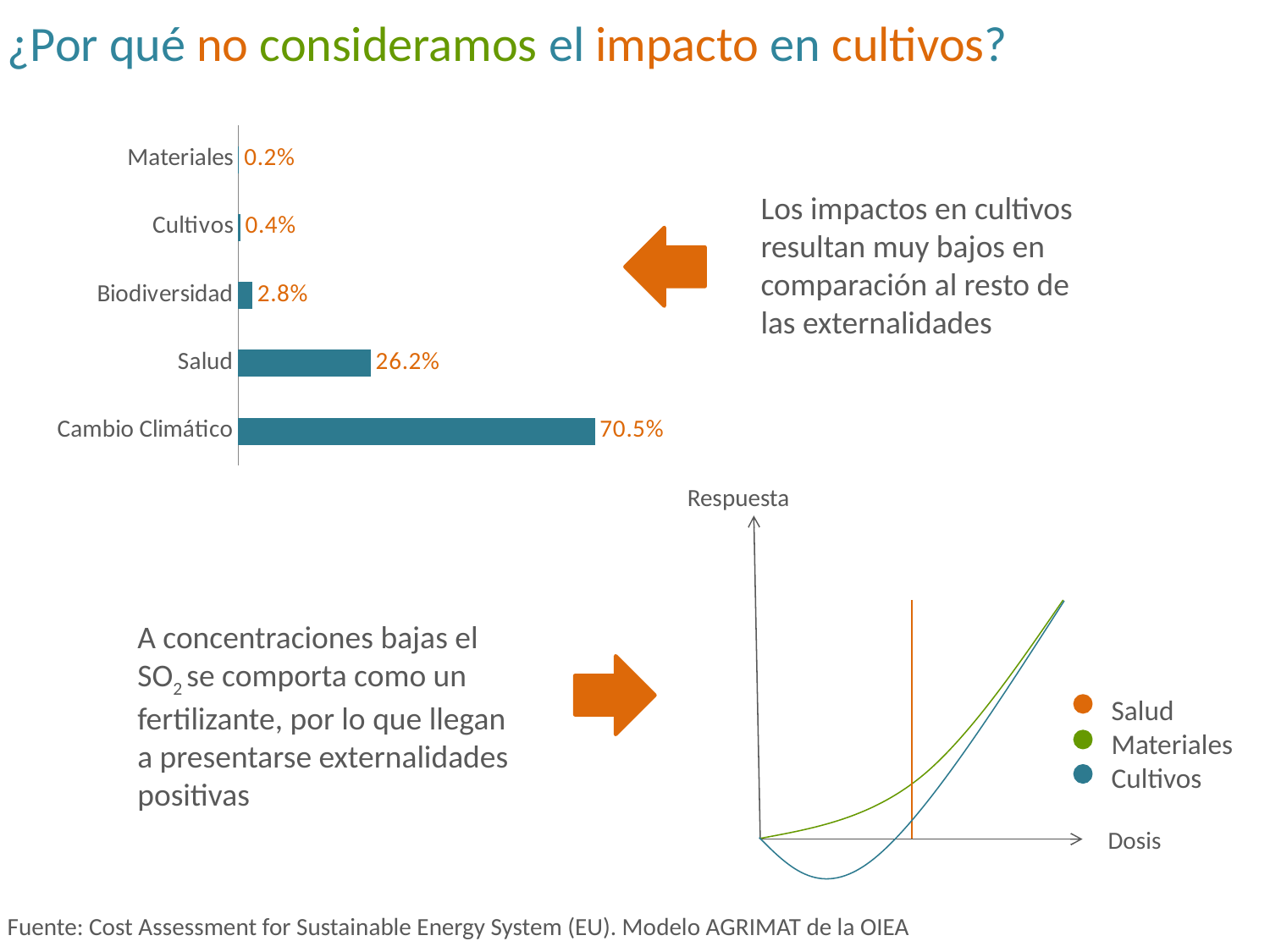
In the bar chart at the top left, what is the value for Biodiversidad? 2.8% In the bar chart at the top left, what is the value for Cambio Climático? 70.5% What kind of chart is the chart at the top left of the slide? Bar chart How many entries does the legend of the Respuesta vs Dosis chart at the bottom right list? 3 In the bar chart at the top left, which category has the lowest value? Materiales In the bar chart at the top left, what is the value for Cultivos? 0.4% What is the label on the horizontal axis of the chart at the bottom right? Dosis In the bar chart at the top left, what is the value for Salud? 26.2% In the bar chart at the top left, which category has the highest value? Cambio Climático How many categories are shown in the bar chart at the top left? 5 In the bar chart at the top left, which is larger, the value for Salud or the value for Biodiversidad? Salud In the bar chart at the top left, what is the difference between the values for Cambio Climático and Salud? 44.3%